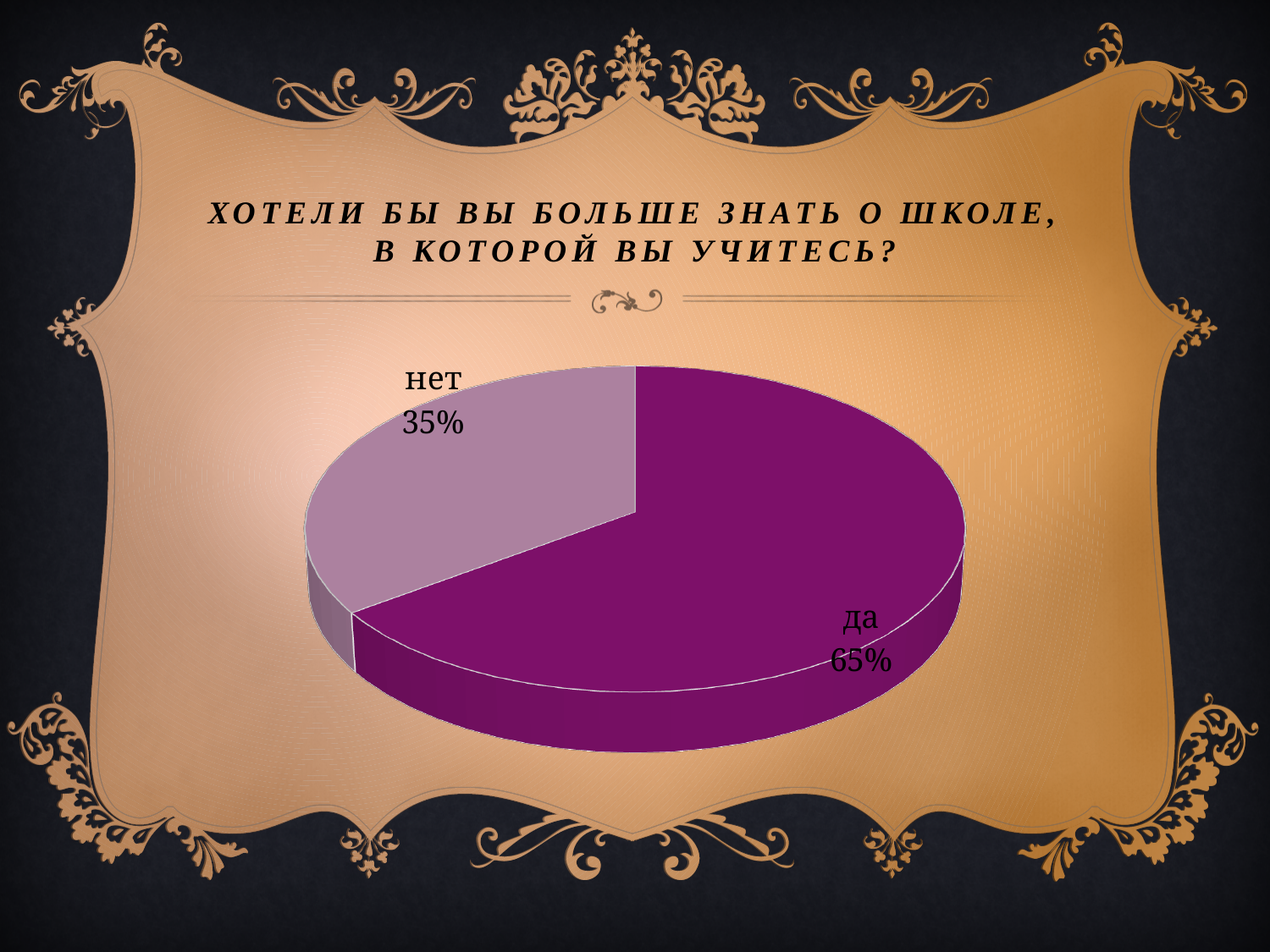
What share of the pie does the "нет" slice represent? 35% Which answer has the largest share of the pie? да What colour is the "да" slice of the pie? purple How many slices does the pie chart have? 2 What percentage of respondents answered "да"? 65% Which answer has the smallest share of the pie? нет Which slice is larger, "да" or "нет"? да What kind of chart is shown on the slide? pie chart What percentage of respondents answered "нет"? 35% What is the difference in percentage points between the "да" and "нет" slices? 30 What is the title of the chart on the slide? ХОТЕЛИ БЫ ВЫ БОЛЬШЕ ЗНАТЬ О ШКОЛЕ, В КОТОРОЙ ВЫ УЧИТЕСЬ?